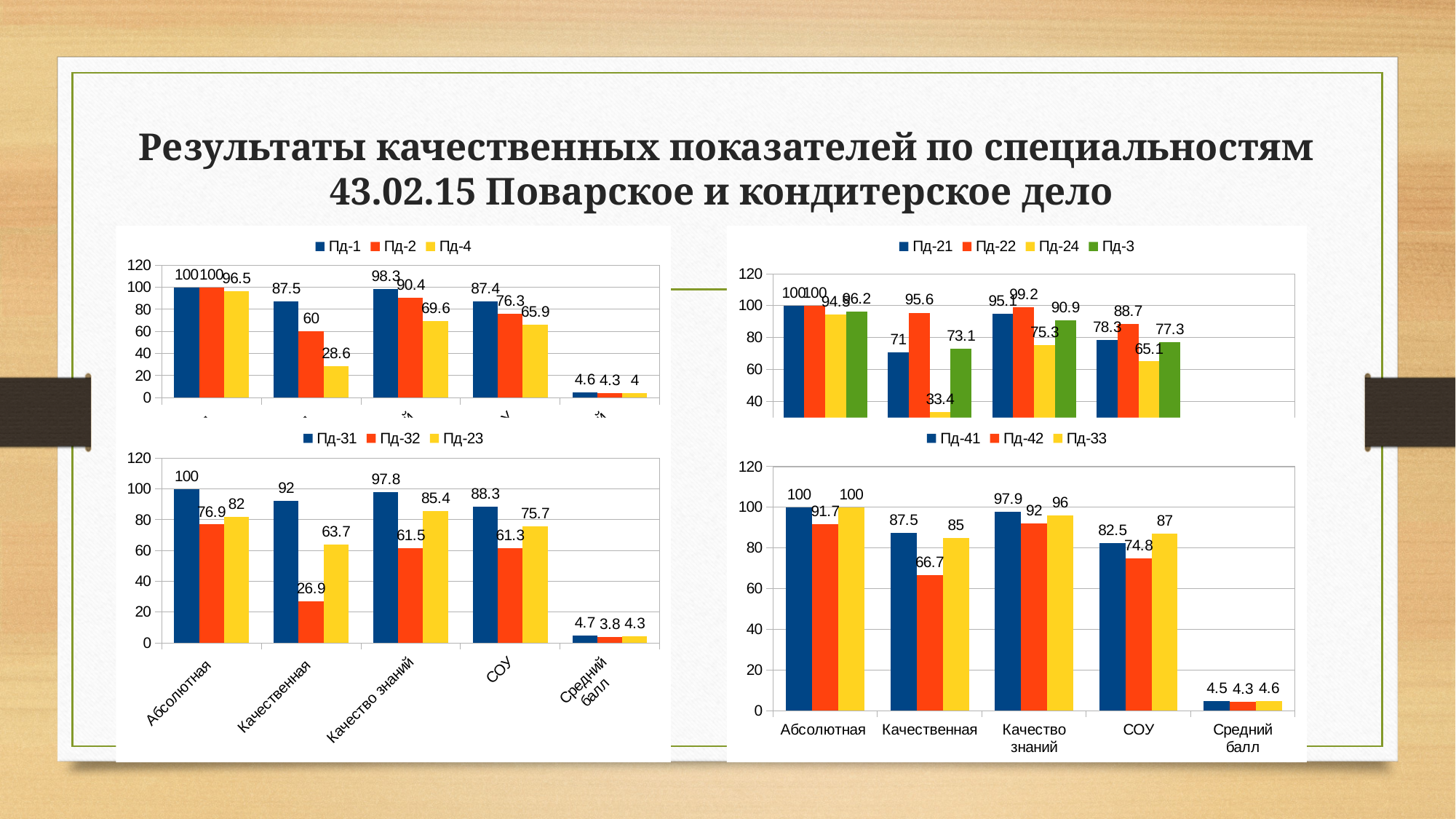
In the bottom-left chart (legend Пд-31, Пд-32, Пд-23), which series has the lowest value for Качество знаний? Пд-32 How many categories are shown on the x axis of the bottom-right chart? 5 In the bottom-right chart (legend Пд-41, Пд-42, Пд-33), which is larger for Качественная: Пд-41 or Пд-33? Пд-41 In the bottom-right chart (legend Пд-41, Пд-42, Пд-33), what is the value of Пд-42 for СОУ? 74.8 In the bottom-left chart (legend Пд-31, Пд-32, Пд-23), what is the difference between Пд-31 and Пд-23 for Качественная? 28.3 How many series does the legend of the top-right chart list? 4 What kind of chart is the bottom-left chart? Bar chart In the bottom-right chart (legend Пд-41, Пд-42, Пд-33), what is the difference between Пд-41 and Пд-42 for Абсолютная? 8.3 In the bottom-left chart (legend Пд-31, Пд-32, Пд-23), what is the value of Пд-32 for Качественная? 26.9 In the bottom-right chart (legend Пд-41, Пд-42, Пд-33), which series has the highest value for СОУ? Пд-33 In the bottom-left chart (legend Пд-31, Пд-32, Пд-23), what is the value of Пд-23 for Средний балл? 4.3 What are the legend entries of the top-left chart? Пд-1, Пд-2, Пд-4